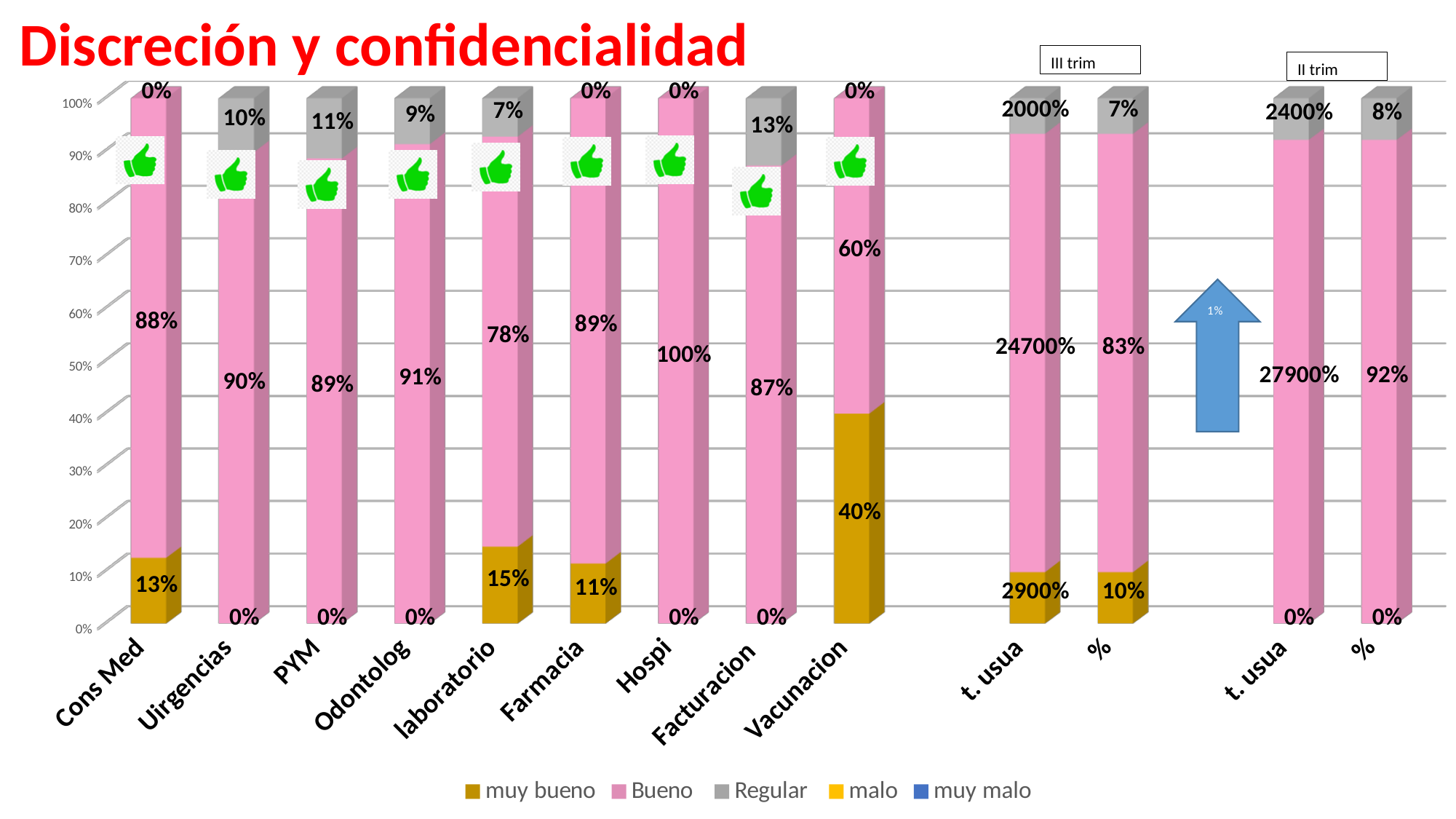
What is the Bueno value for the % bar under II trim? 92% What is the difference between the Bueno values for Odontolog and laboratorio? 13% What is the muy bueno value for laboratorio? 15% What type of chart is shown on the slide? Stacked bar chart Which category has the lowest Bueno value? Vacunacion What is the Bueno value for Cons Med? 88% What is the Regular value for Facturacion? 13% How many series does the legend list? 5 Which is larger, the Regular value for PYM or the Regular value for Uirgencias? PYM What is the title of the chart? Discreción y confidencialidad What is the muy bueno value for Vacunacion? 40%